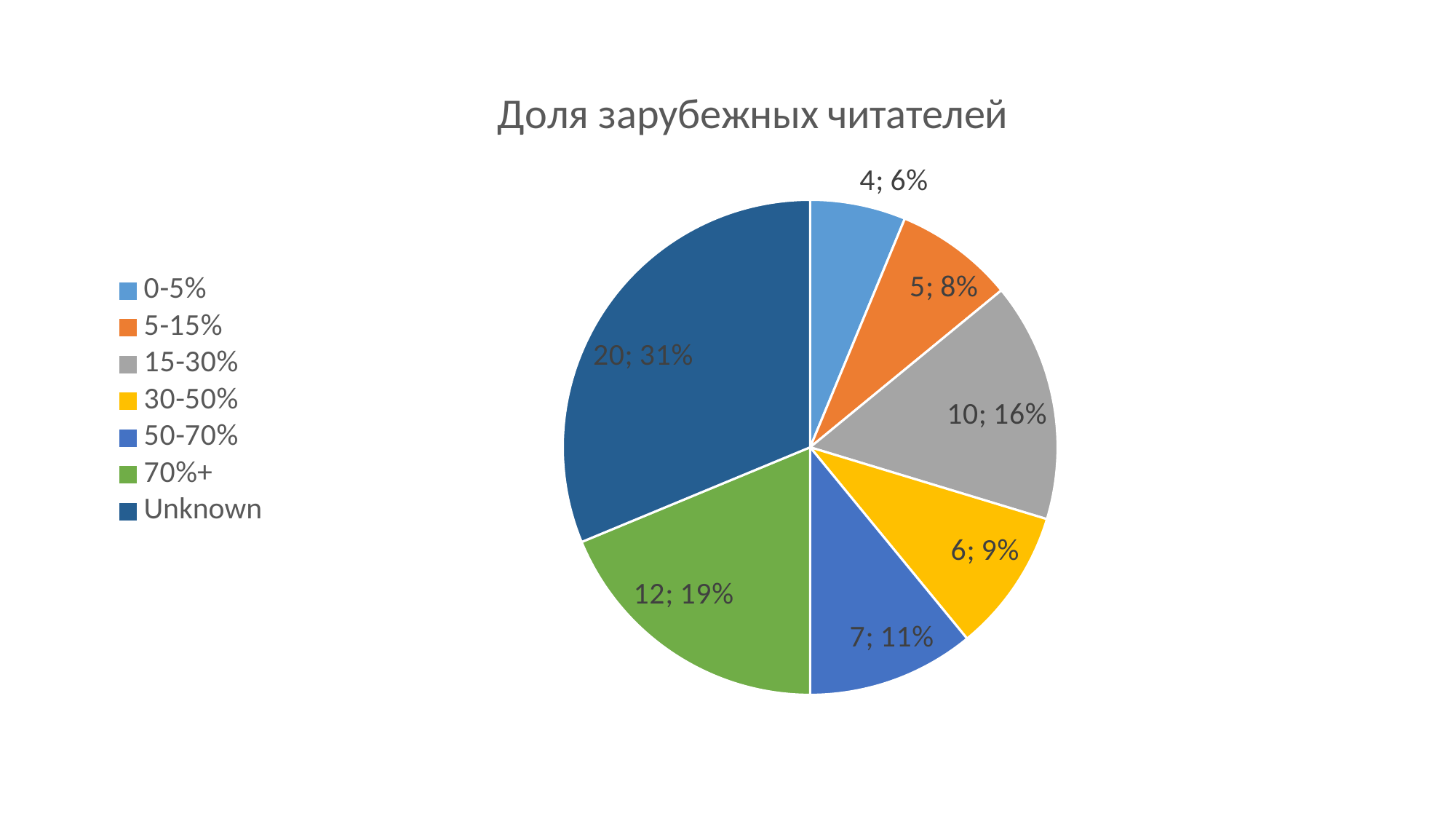
What is the count shown for the 5-15% slice? 5 Which category has the largest slice? Unknown What kind of chart is shown on the slide? pie chart Which is larger, the count for 50-70% or the count for 30-50%? 50-70% Which category has the smallest slice? 0-5% What share of the pie does the Unknown slice represent? 31% How many slices does the pie chart have? 7 What is the title of the chart? Доля зарубежных читателей What is the difference between the counts for Unknown and 70%+? 8 What is the count shown for the 15-30% slice? 10 What is the total of all the counts shown on the pie chart? 64 What share of the pie does the 70%+ slice represent? 19%